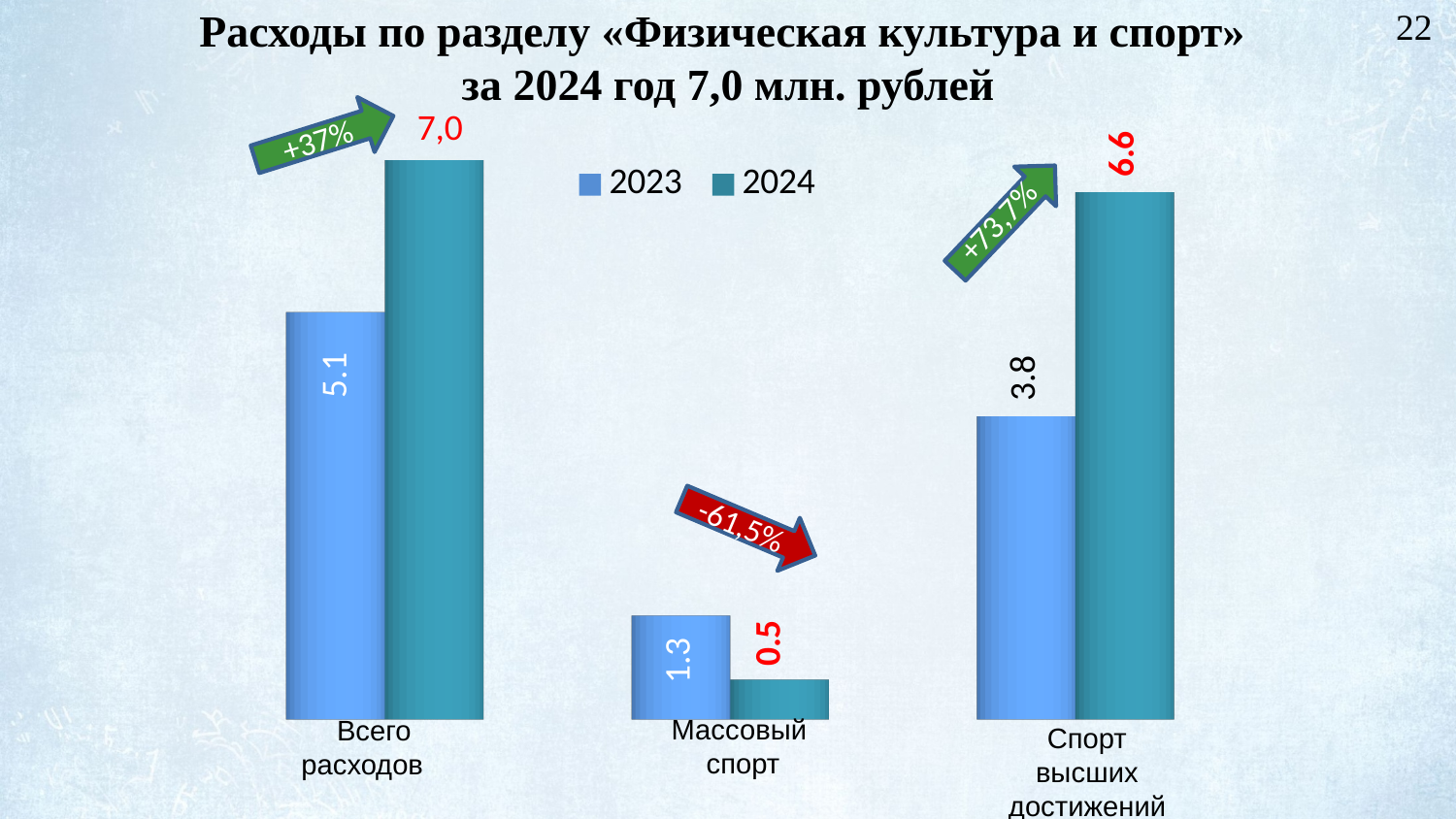
What is the value for 2023 in the "Спорт высших достижений" category? 3.8 What is the difference between the 2024 and 2023 values for "Спорт высших достижений"? 2.8 What is the value for 2024 in the "Всего расходов" category? 7,0 What is the value for 2023 in the "Массовый спорт" category? 1.3 How many categories are shown on the x axis? 3 Which category has the lowest 2024 value? Массовый спорт What is the value for 2024 in the "Спорт высших достижений" category? 6.6 What kind of chart is shown on the slide? Bar chart In the "Массовый спорт" category, which is larger: the 2023 value or the 2024 value? 2023 Which category has the highest 2023 value? Всего расходов How many series does the legend list? 2 What percentage change is shown by the arrow above the "Массовый спорт" category? -61,5%